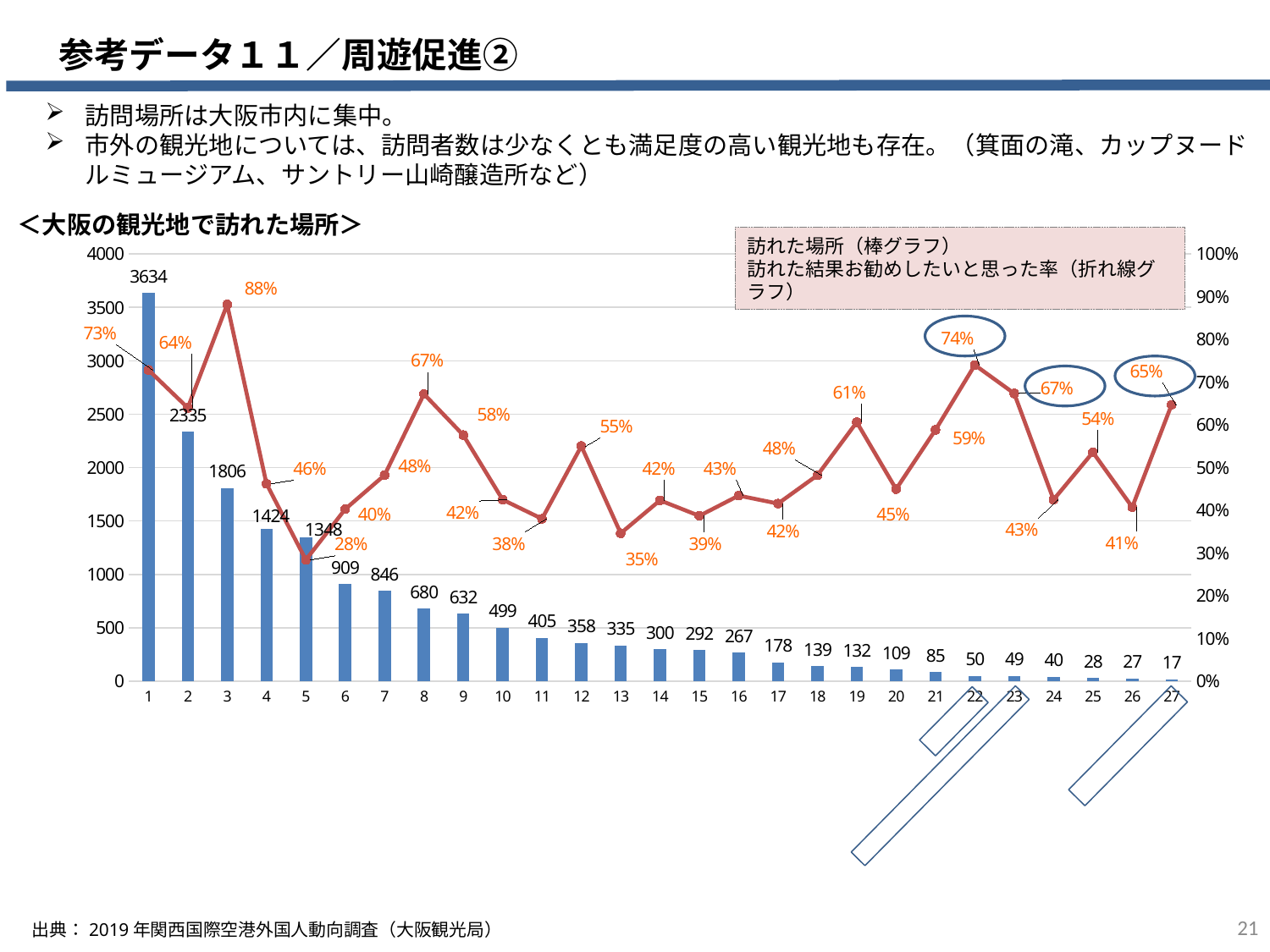
Which category has the lowest bar value? 27 What is the line (recommendation rate) value for category 3? 88% What is the bar value for category 1? 3634 Which category has the highest bar value? 1 What is the difference between the bar values for category 1 and category 2? 1299 Which category has the lowest line (recommendation rate) value? 5 Do the bar values rise or fall from category 1 to category 27? fall What is the bar value for category 8? 680 What is the line value for category 22? 74% What kind of chart is this? Combined bar and line chart How many categories are shown on the x axis? 27 Which is larger, the line value for category 19 or for category 21? category 19